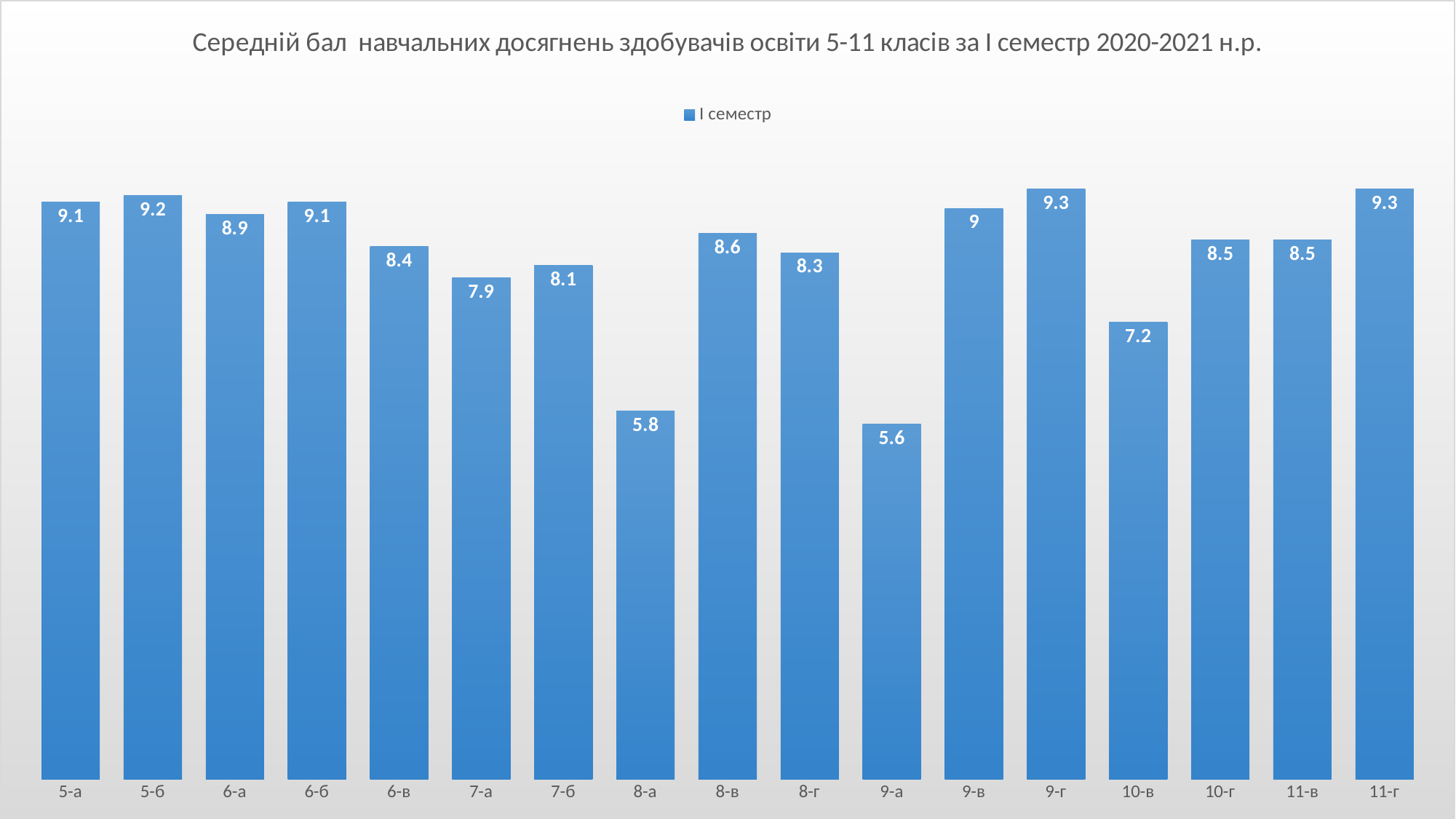
Which is larger, the value for 8-в or the value for 8-г? 8-в How many series does the legend list? 1 Which category has the lowest value? 9-а What is the value for 5-б? 9.2 What kind of chart is this? bar chart What is the difference between the values for 6-в and 7-а? 0.5 How many categories are shown on the x axis? 17 Which categories share the highest value? 9-г and 11-г What is the difference between the values for 9-г and 9-а? 3.7 What is the value for 8-а? 5.8 What is the value for 9-в? 9 What is the value for 10-в? 7.2